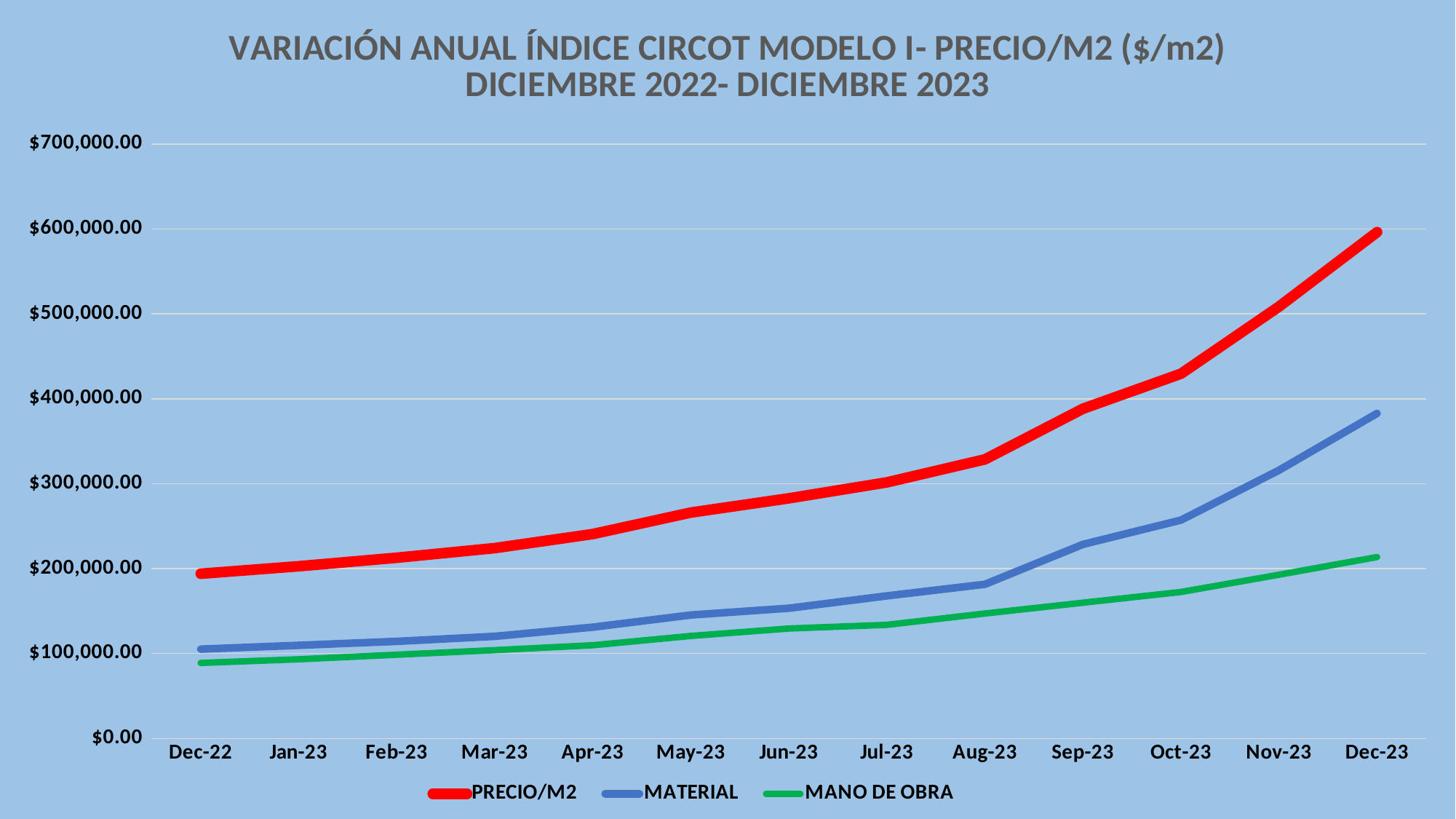
How many series does the legend list? 3 What colour is the PRECIO/M2 line in the legend? red Is the value for MANO DE OBRA at Dec-22 greater or less than $100,000.00? less Does the PRECIO/M2 line rise or fall from Dec-22 to Dec-23? rises Is the value for PRECIO/M2 at Aug-23 greater or less than $300,000.00? greater How many months are plotted along the x axis? 13 Is the value for MATERIAL at Dec-23 greater or less than $400,000.00? less Which series has the lowest value at Dec-22? MANO DE OBRA Which series has the highest value at Dec-23? PRECIO/M2 At Oct-23, which is larger: MATERIAL or MANO DE OBRA? MATERIAL What kind of chart is shown on the slide? line chart